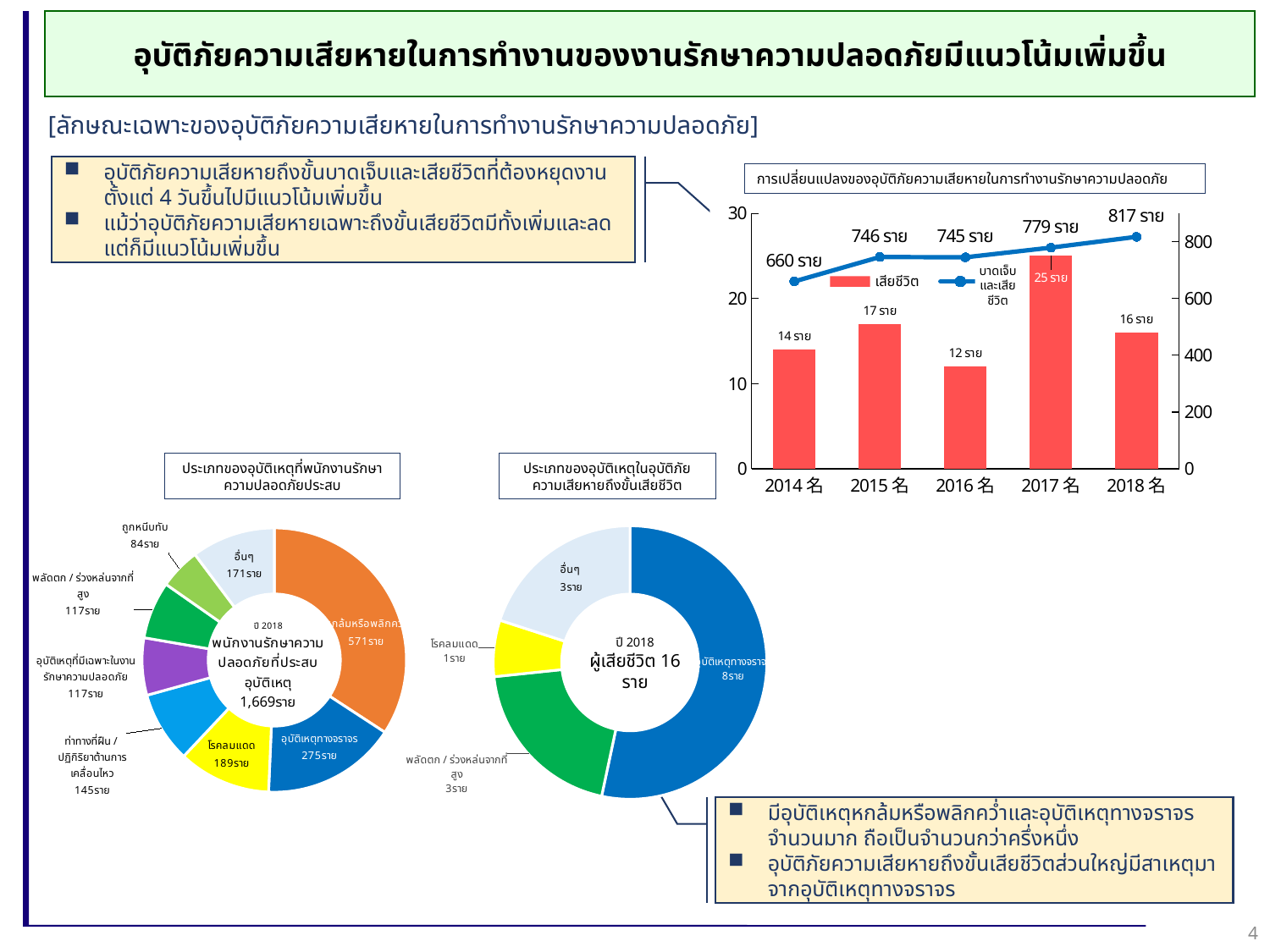
In the chart 'การเปลี่ยนแปลงของอุบัติภัยความเสียหายในการทำงานรักษาความปลอดภัย', how many years are shown on the x axis? 5 In the chart 'การเปลี่ยนแปลงของอุบัติภัยความเสียหายในการทำงานรักษาความปลอดภัย', what is the difference between the บาดเจ็บและเสียชีวิต values for 2018 and 2014? 157 ราย In the chart 'การเปลี่ยนแปลงของอุบัติภัยความเสียหายในการทำงานรักษาความปลอดภัย', which year has the lowest เสียชีวิต bar? 2016 In the chart 'การเปลี่ยนแปลงของอุบัติภัยความเสียหายในการทำงานรักษาความปลอดภัย', how many series does the legend list? 2 In the chart 'การเปลี่ยนแปลงของอุบัติภัยความเสียหายในการทำงานรักษาความปลอดภัย', is the เสียชีวิต value for 2015 larger or the value for 2018? 2015 In the donut chart 'ประเภทของอุบัติเหตุที่พนักงานรักษาความปลอดภัยประสบ', what is the total number of cases shown in the centre? 1,669ราย In the donut chart 'ประเภทของอุบัติเหตุในอุบัติภัยความเสียหายถึงขั้นเสียชีวิต', which category has the largest slice? อุบัติเหตุทางจราจร In the chart 'การเปลี่ยนแปลงของอุบัติภัยความเสียหายในการทำงานรักษาความปลอดภัย', does the บาดเจ็บและเสียชีวิต line generally rise or fall from 2014 to 2018? rise In the chart 'การเปลี่ยนแปลงของอุบัติภัยความเสียหายในการทำงานรักษาความปลอดภัย', what is the value of the บาดเจ็บและเสียชีวิต line for 2018? 817 ราย What kind of chart is 'ประเภทของอุบัติเหตุในอุบัติภัยความเสียหายถึงขั้นเสียชีวิต'? donut (pie) chart In the chart 'การเปลี่ยนแปลงของอุบัติภัยความเสียหายในการทำงานรักษาความปลอดภัย', what is the value of the เสียชีวิต bar for 2017? 25 ราย In the donut chart 'ประเภทของอุบัติเหตุที่พนักงานรักษาความปลอดภัยประสบ', how many cases are shown for โรคลมแดด? 189ราย